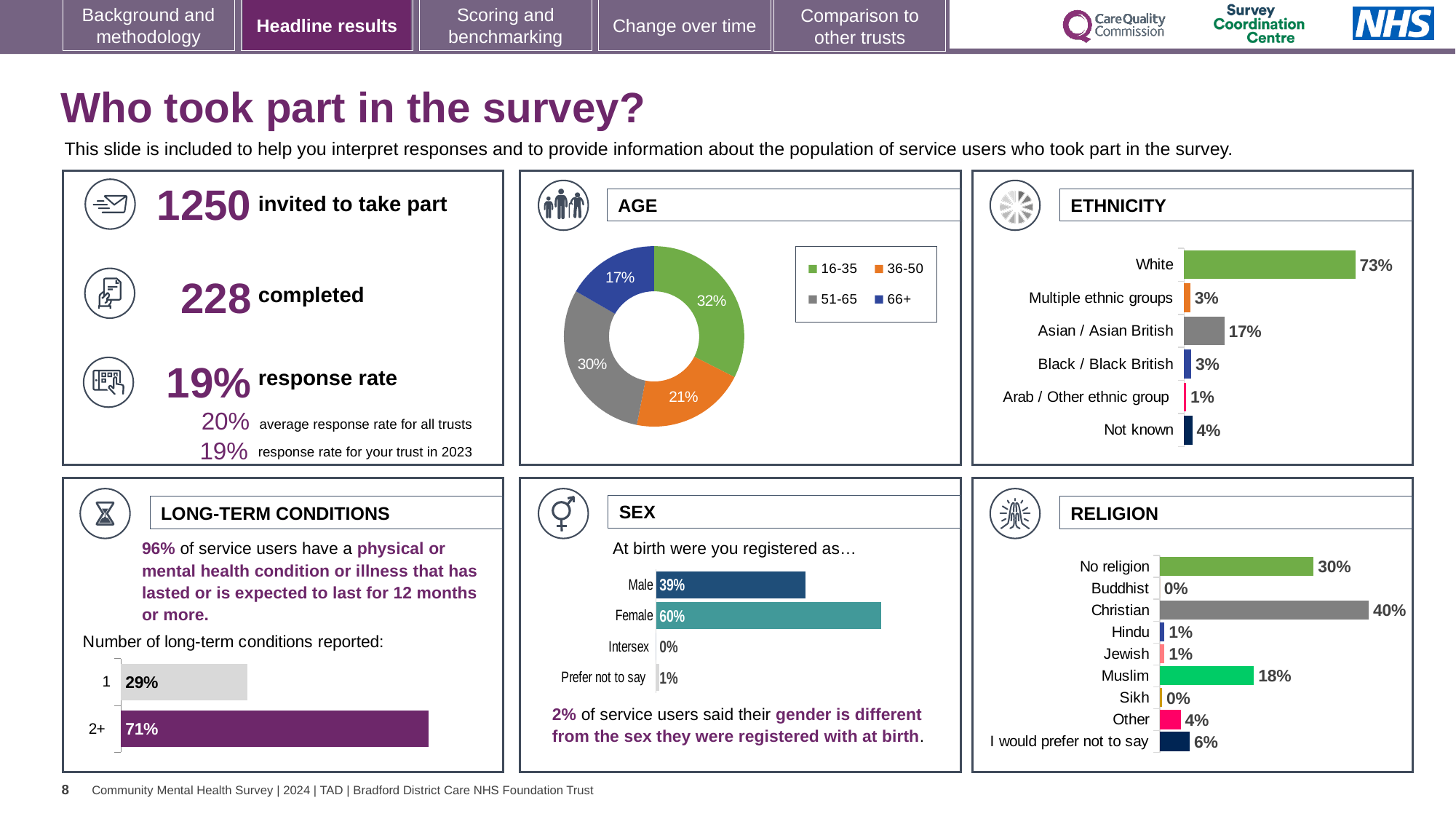
In the ETHNICITY chart, which category has the highest value? White In the SEX chart, which is larger, Male or Female? Female In the AGE chart, which age group has the smallest share? 66+ In the ETHNICITY chart, what is the value for Asian / Asian British? 17% In the RELIGION chart, which religion has the highest value? Christian In the SEX chart, what is the value for Female? 60% In the LONG-TERM CONDITIONS chart, what percentage reported 2+ long-term conditions? 71% How many age groups does the legend of the AGE chart list? 4 How many categories are shown in the ETHNICITY chart? 6 In the ETHNICITY chart, what is the difference between White and Asian / Asian British? 56% In the AGE chart, what percentage of respondents were aged 16-35? 32% What kind of chart is the AGE chart? Doughnut (pie) chart